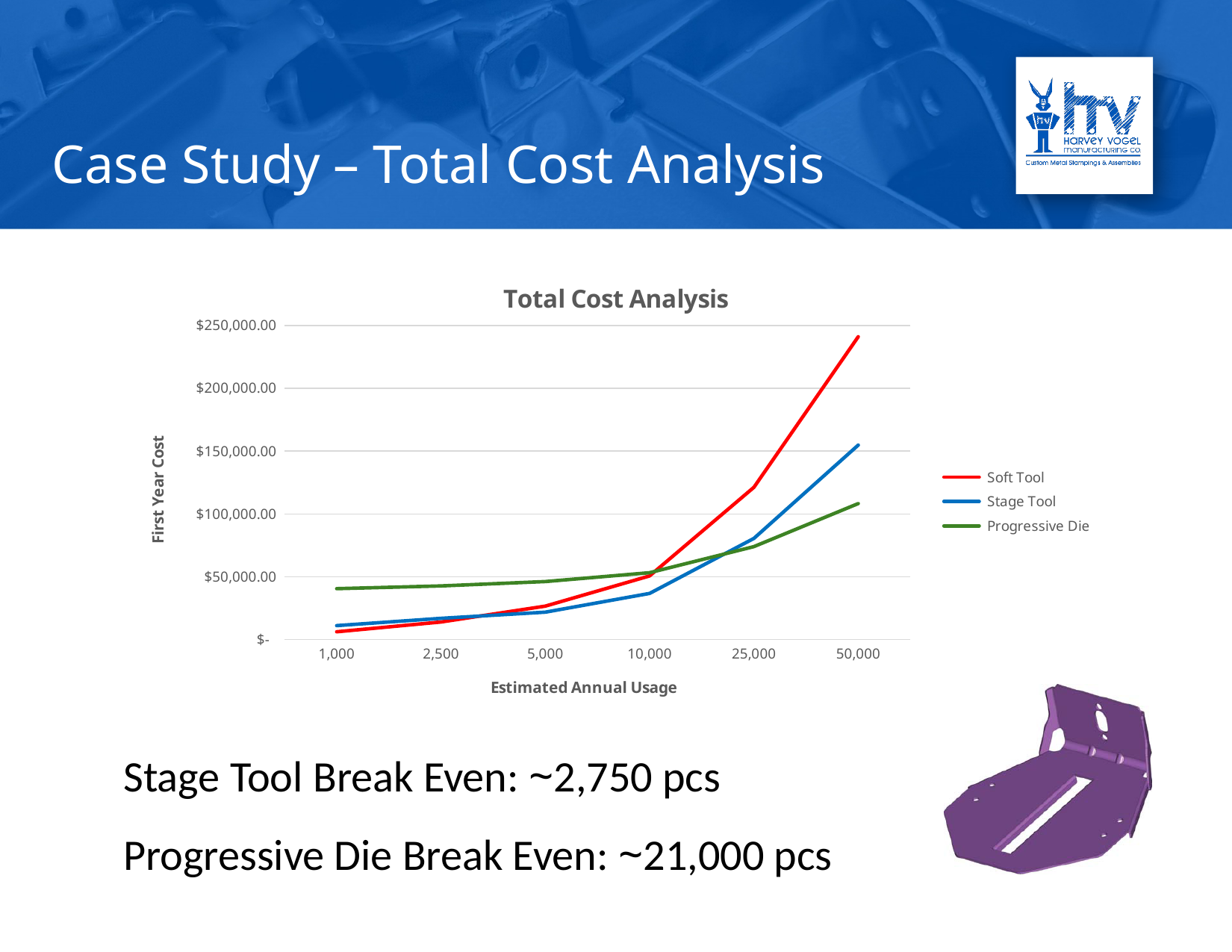
Which series has the lowest first year cost at 1,000 units? Soft Tool At 50,000 units, which has the higher first year cost: Soft Tool or Progressive Die? Soft Tool Is the Stage Tool value at 1,000 units greater or less than $50,000.00? less At 1,000 units, which has the higher first year cost: Progressive Die or Soft Tool? Progressive Die Is the Stage Tool value at 50,000 units greater or less than $100,000.00? greater What kind of chart is the Total Cost Analysis chart? line chart Is the Soft Tool value at 50,000 units greater or less than $200,000.00? greater Which series has the highest first year cost at 50,000 units? Soft Tool How many series does the legend of the Total Cost Analysis chart list? 3 Does the Soft Tool line rise or fall as Estimated Annual Usage increases? rise How many Estimated Annual Usage values are shown on the x axis of the Total Cost Analysis chart? 6